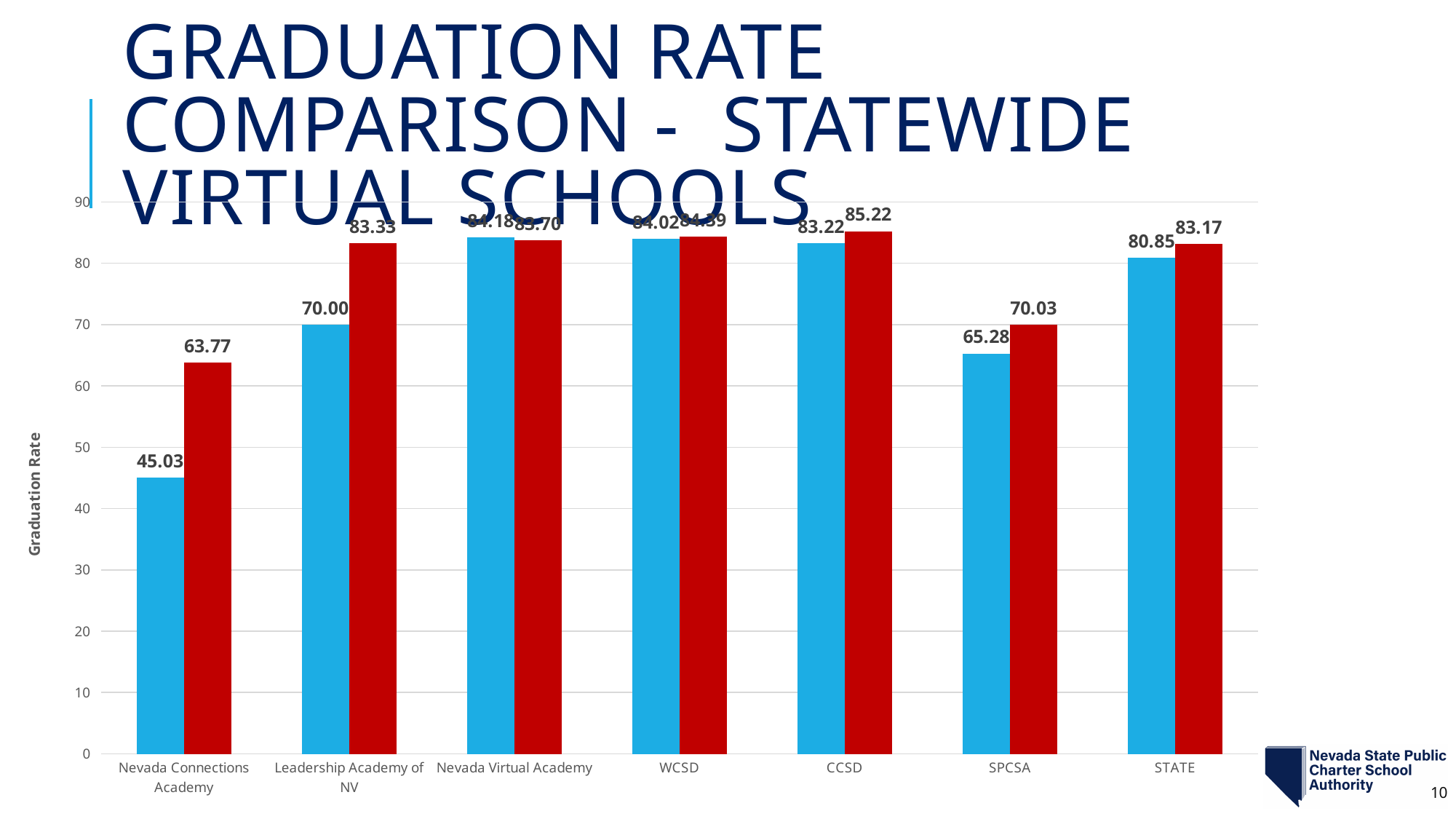
What is the difference between the red and blue bars for Leadership Academy of NV? 13.33 What is the value of the red bar for SPCSA? 70.03 How many categories are shown on the x axis? 7 What is the value of the red bar for CCSD? 85.22 What is the difference between the red and blue bars for Nevada Connections Academy? 18.74 What is the value of the blue bar for Nevada Connections Academy? 45.03 What is the difference between the red and blue bars for STATE? 2.32 Is the value of the blue bar for SPCSA greater or less than 70? less Which category has the lowest blue bar? Nevada Connections Academy What kind of chart is shown on the slide? bar chart For SPCSA, which bar is larger, the blue or the red? red What is the value of the blue bar for STATE? 80.85